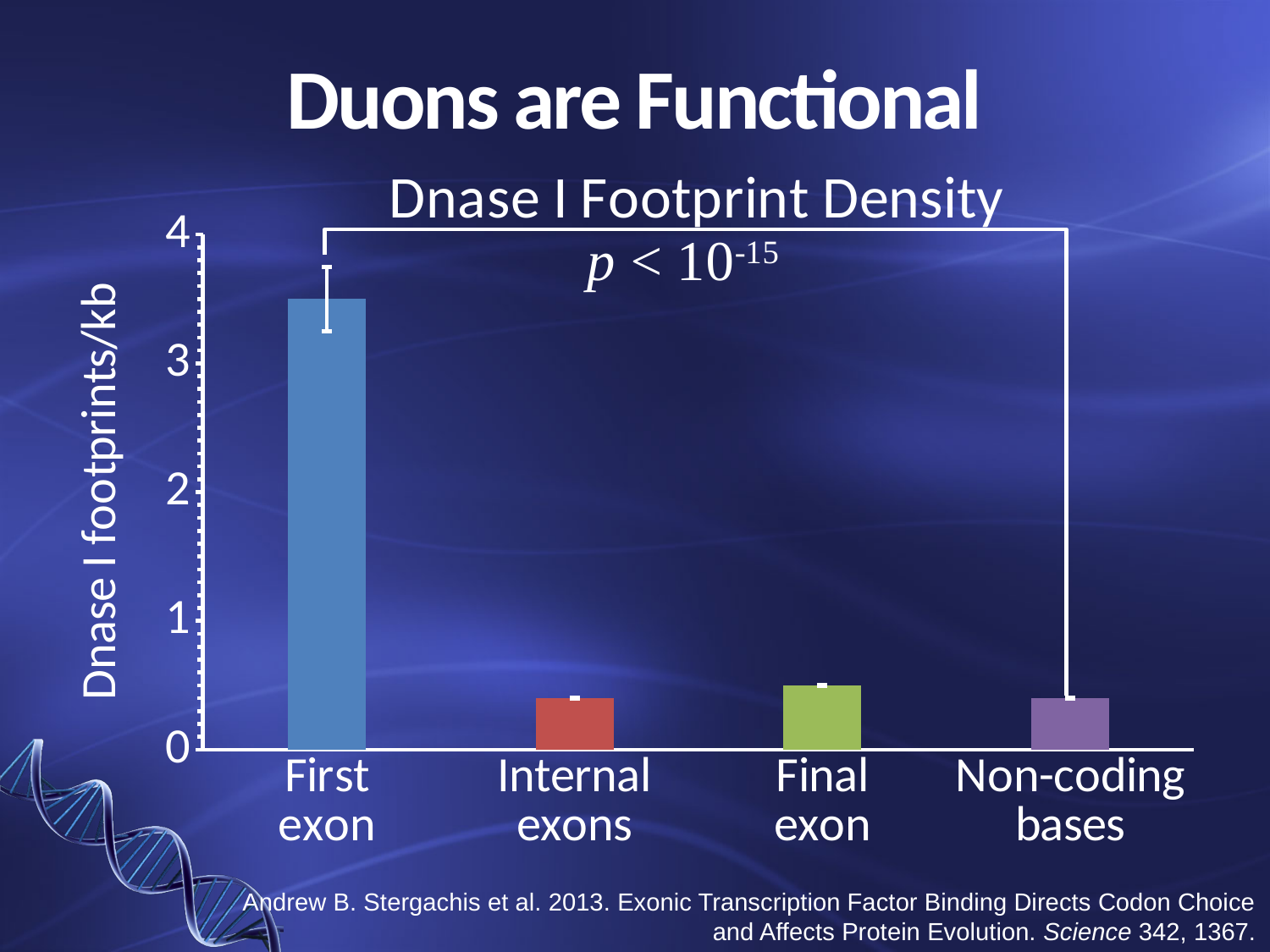
Is the value for Non-coding bases greater or less than 1? less What kind of chart is shown on the slide? bar chart Which is larger, the value for First exon or the value for Final exon? First exon Which category has the highest Dnase I footprint density? First exon What is the label on the y axis of the chart? Dnase I footprints/kb Is the value for First exon greater or less than 3? greater Which is larger, the value for First exon or the value for Non-coding bases? First exon Is the value for Internal exons greater or less than 1? less What is the title of the chart? Dnase I Footprint Density How many categories are shown on the x axis of the chart? 4